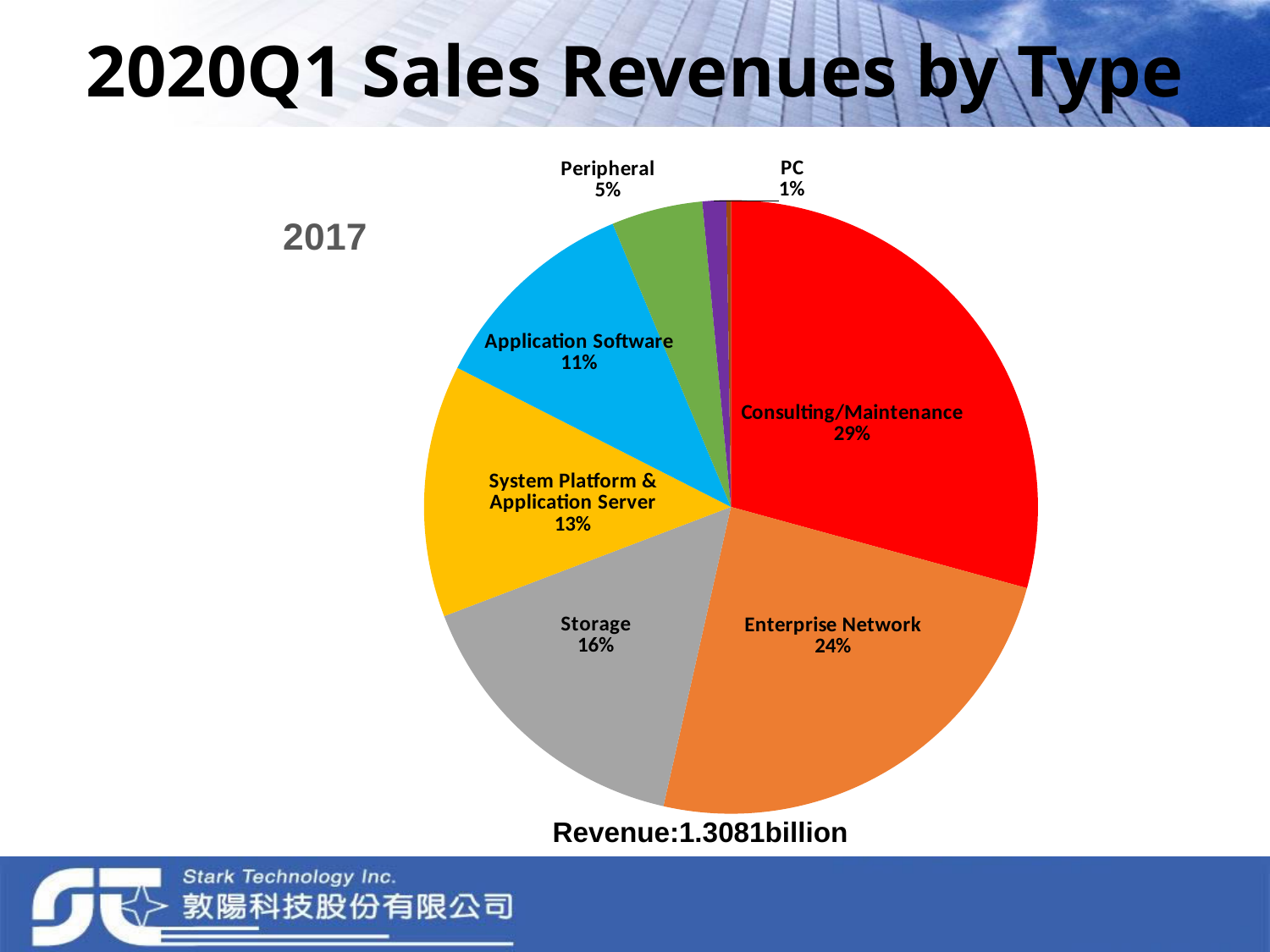
What is the share shown for Storage? 16% What percentage of the pie is Enterprise Network? 24% Which is larger, Storage or Peripheral? Storage Which labelled category has the smallest share? PC What total revenue figure is printed below the chart? Revenue:1.3081billion How many percentage points larger is Consulting/Maintenance than Enterprise Network? 5 What share does Application Software have? 11% Which category has the largest share of sales revenue? Consulting/Maintenance What kind of chart is shown on the slide? Pie chart